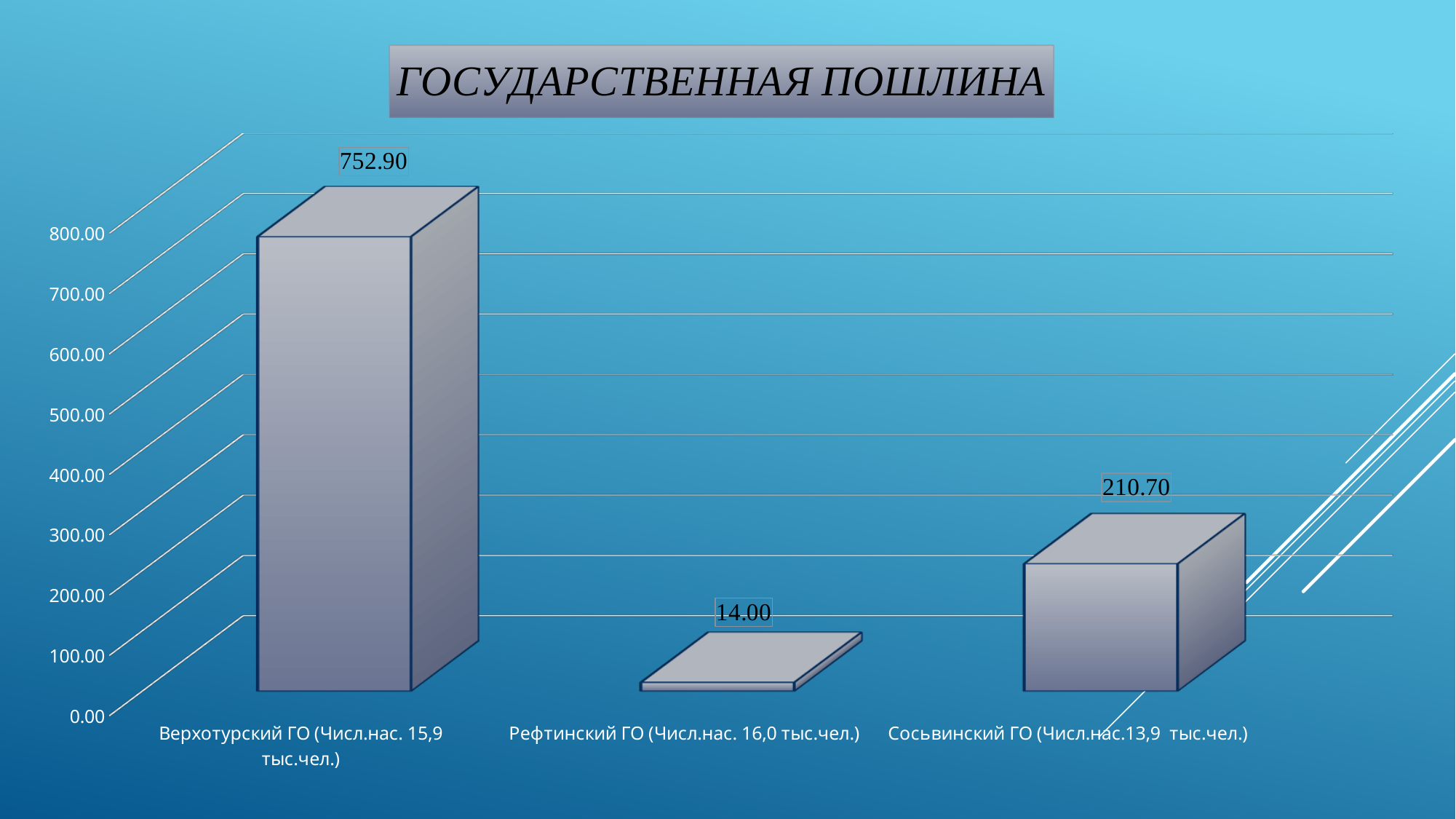
What kind of chart is shown on the slide? bar chart What is the value for Верхотурский ГО? 752.90 What is the difference between the values for Сосьвинский ГО and Рефтинский ГО? 196.70 Which category has the lowest value? Рефтинский ГО What is the value for Рефтинский ГО? 14.00 How many categories are shown on the chart? 3 What is the value for Сосьвинский ГО? 210.70 Which is larger, the value for Сосьвинский ГО or the value for Рефтинский ГО? Сосьвинский ГО Which category has the highest value? Верхотурский ГО Is the value for Сосьвинский ГО greater or less than 300? less What is the title of the chart? ГОСУДАРСТВЕННАЯ ПОШЛИНА What is the difference between the values for Верхотурский ГО and Сосьвинский ГО? 542.20